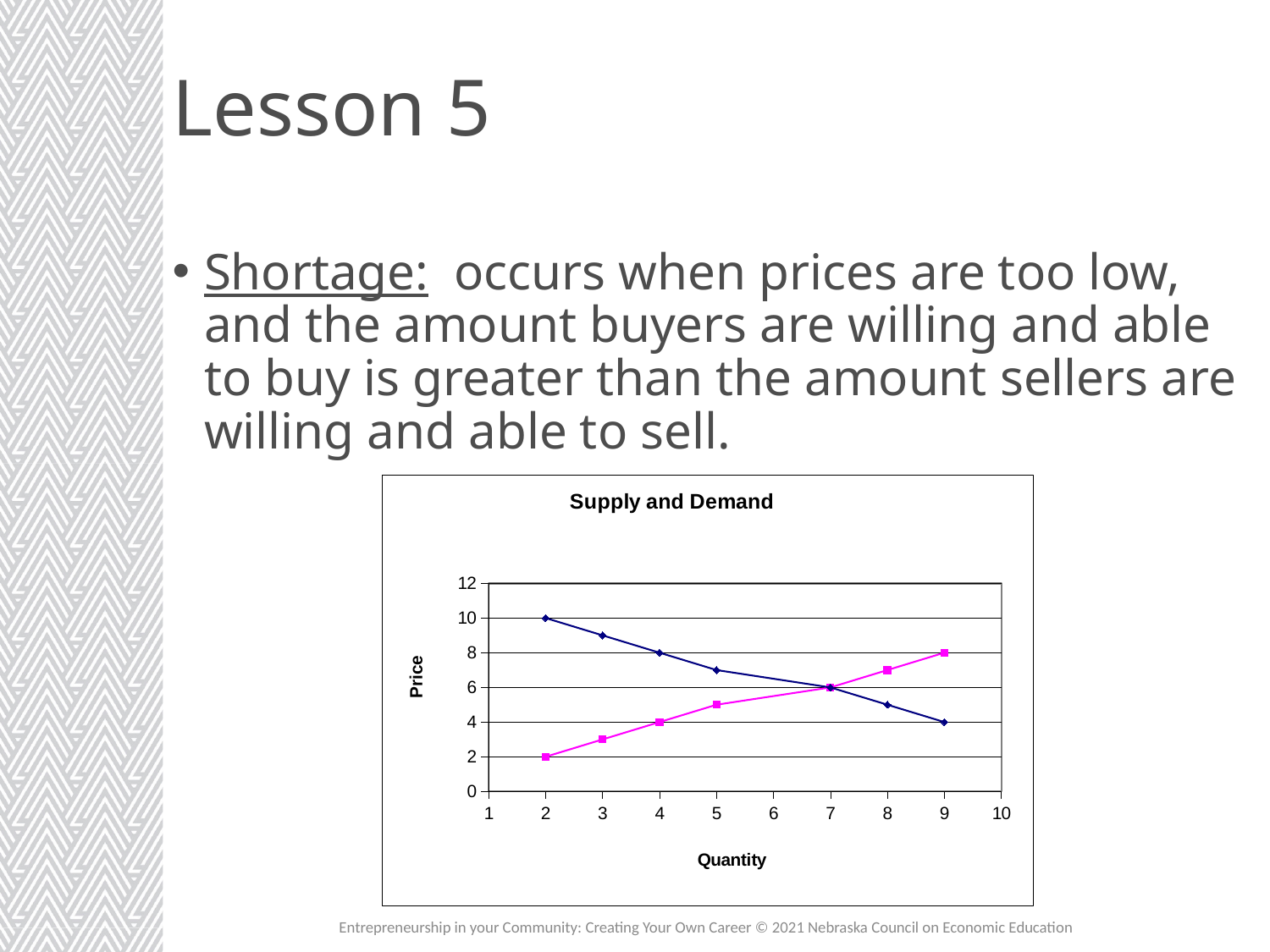
Is the price on the pink line at quantity 3 greater or less than 4? less What is the price on the pink line at quantity 2? 2 Does the blue line with diamond markers rise or fall as quantity increases? fall Does the pink line with square markers rise or fall as quantity increases? rise What is the title of the chart? Supply and Demand What is the price on the blue line at quantity 2? 10 At quantity 4, which line has the higher price, the blue line or the pink line? the blue line At what price do the blue and pink lines cross? 6 What is the price on the blue line at quantity 9? 4 What are the axis titles of the chart? Quantity (x axis) and Price (y axis) What kind of chart is shown on the slide? line chart What is the price on the pink line at quantity 9? 8